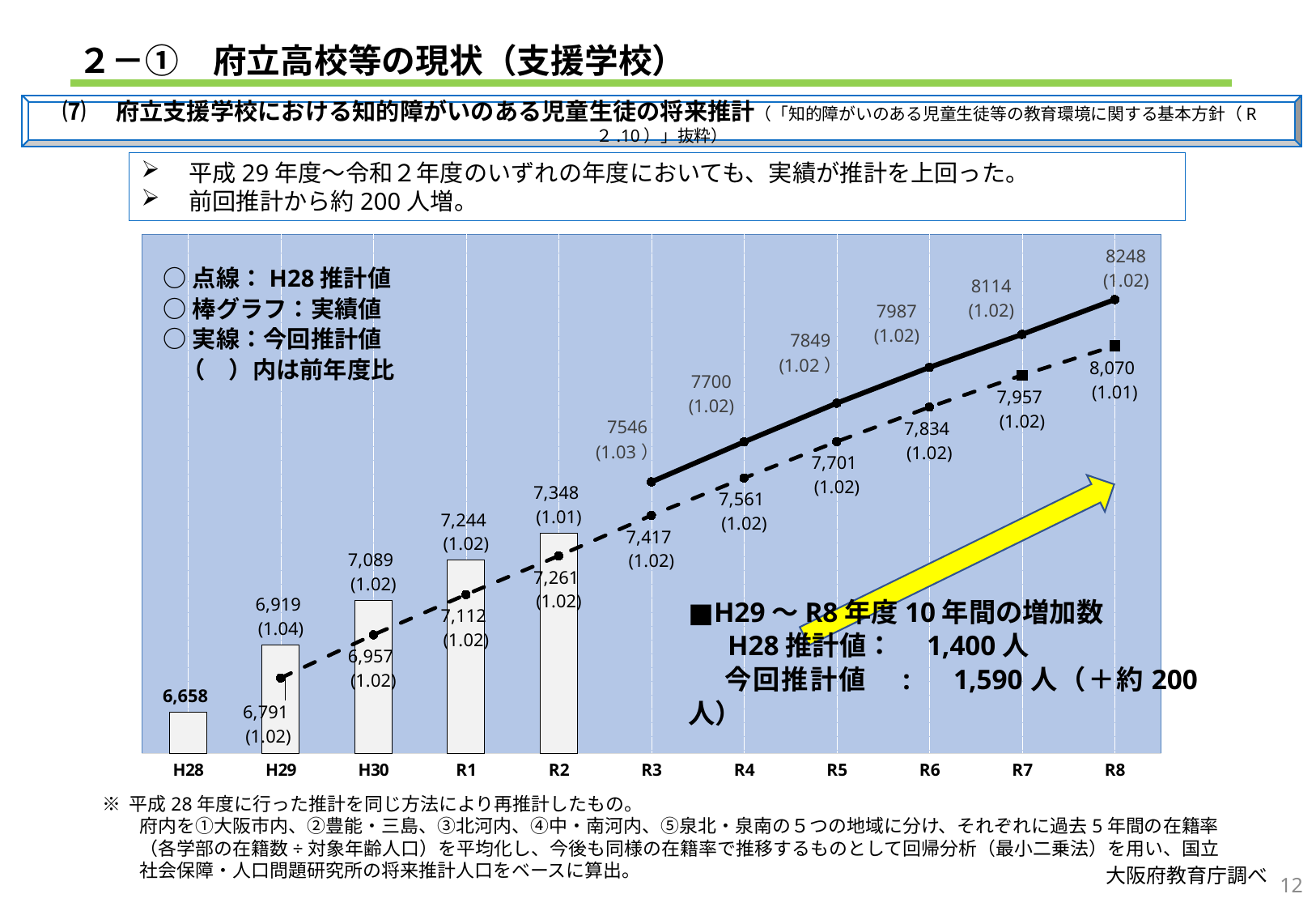
実線（今回推計値）のR3の値はいくつですか。 7546 H29において、棒グラフ（実績値）と点線（H28推計値）ではどちらの値が大きいですか。 棒グラフ（実績値） 点線（H28推計値）のR8の値はいくつですか。 8,070 棒グラフ（実績値）で最も値が小さい年度はどれですか。 H28 棒グラフ（実績値）のH28の値はいくつですか。 6,658 横軸には何個の年度が表示されていますか。 11 棒グラフ（実績値）で最も値が大きい年度はどれですか。 R2 R8における実線（今回推計値）と点線（H28推計値）の差はいくつですか。 178 H29の棒グラフ（実績値）の括弧内に示された前年度比はいくつですか。 (1.04) 棒グラフ（実績値）のR2の値はいくつですか。 7,348 実線（今回推計値）はR3からR8にかけて上昇していますか、下降していますか。 上昇 実線（今回推計値）のR8の値はいくつですか。 8248